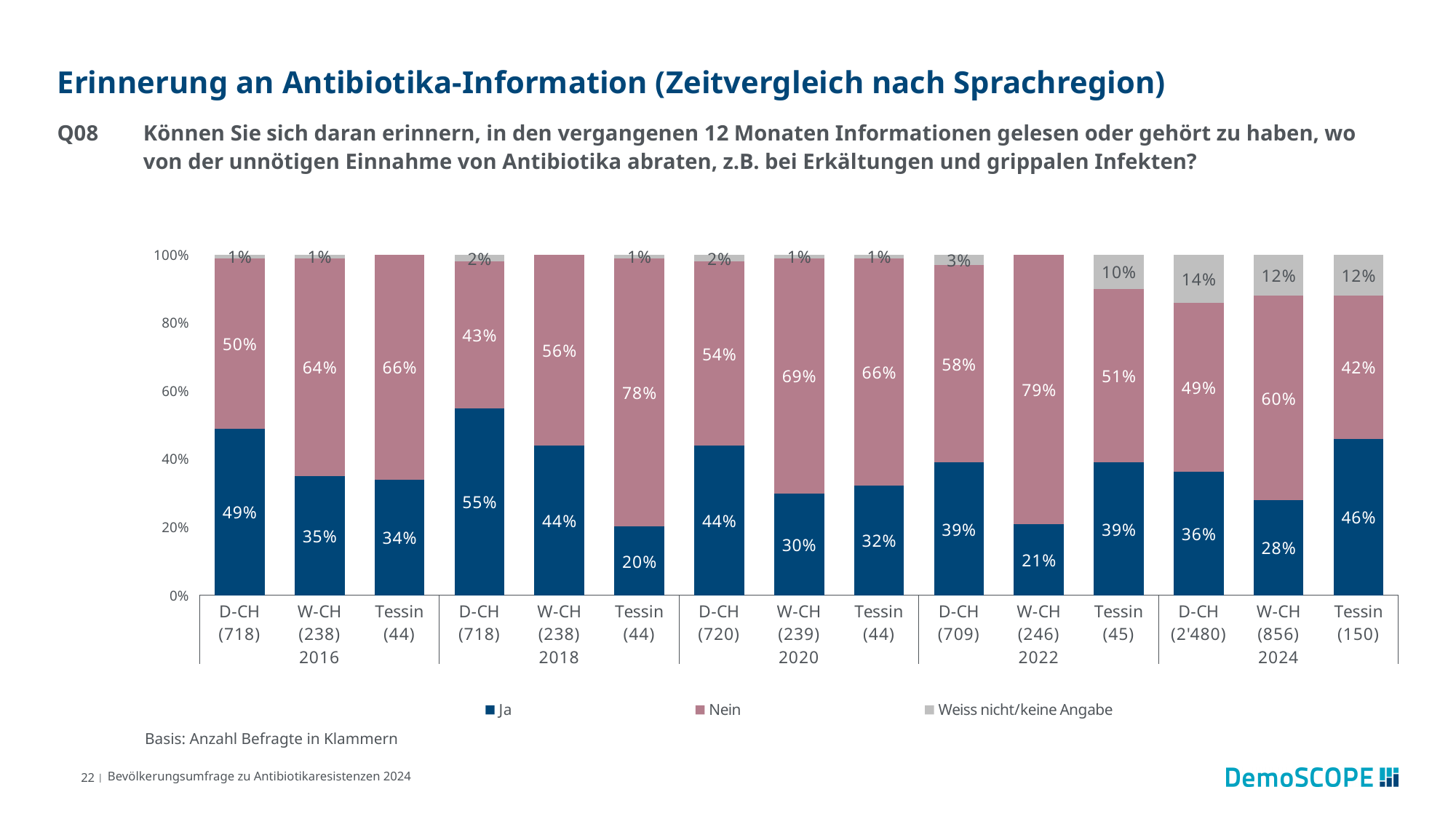
Does the 'Weiss nicht/keine Angabe' share for D-CH rise or fall from 2016 to 2024? Rises What is the difference in the 'Ja' share between D-CH and Tessin in 2016? 15 percentage points What is the 'Nein' value for W-CH in 2022? 79% How many respondents are given in parentheses for Tessin in 2024? 150 Which bar has the lowest 'Ja' share? Tessin 2018 (20%) Which bar has the highest 'Ja' share? D-CH 2018 (55%) What is the 'Ja' value for D-CH in 2018? 55% What kind of chart is shown on the slide? Stacked bar chart How many bars are shown in the chart? 15 What is the 'Weiss nicht/keine Angabe' value for D-CH in 2024? 14% In 2024, which has the larger 'Ja' share, Tessin or W-CH? Tessin How many series does the legend list? 3